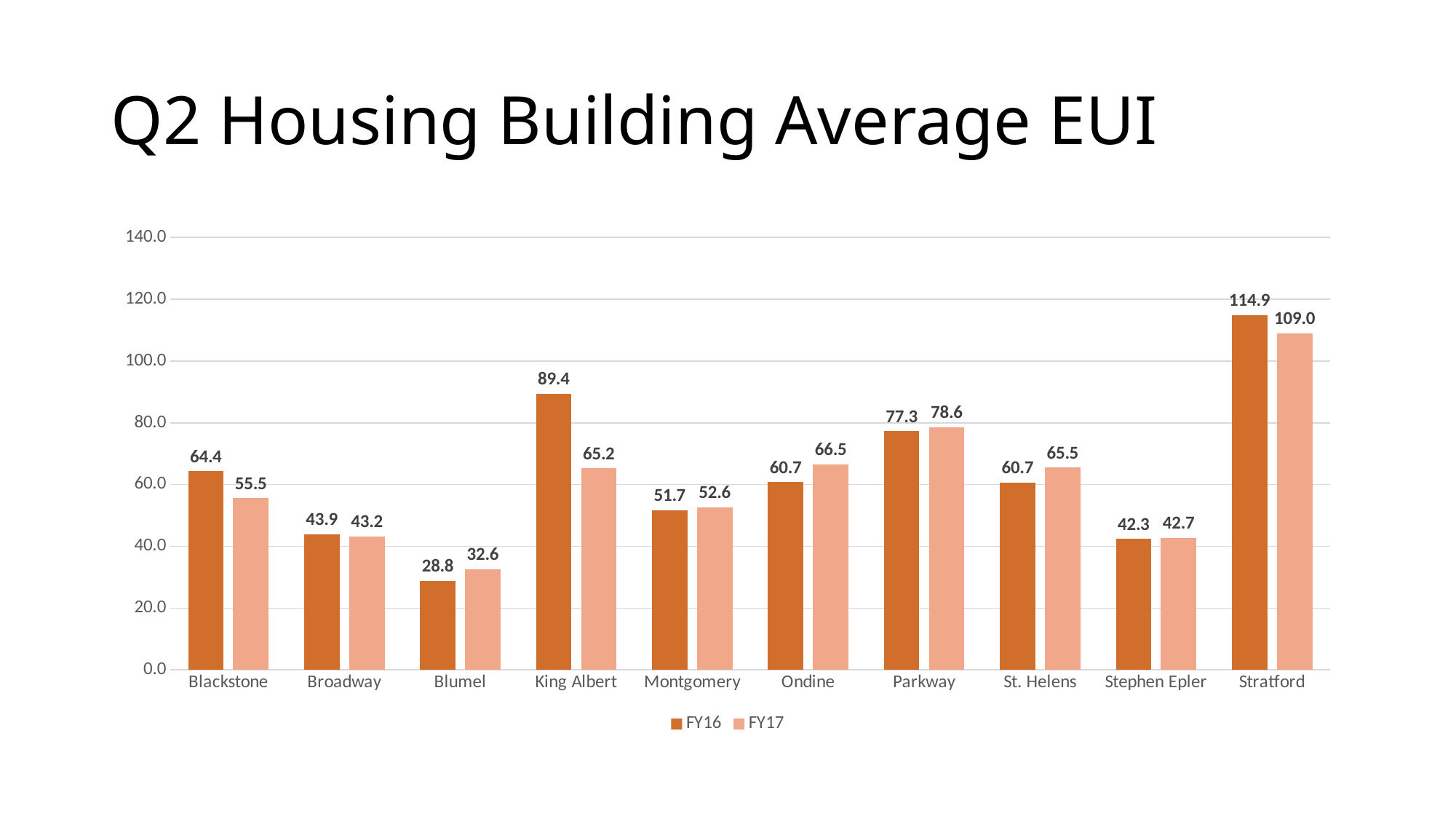
Is the FY16 value for Stratford greater or less than 100.0? greater How many buildings are shown on the x axis? 10 What is the FY16 value for King Albert? 89.4 What is the FY17 value for Blackstone? 55.5 What kind of chart is shown on the slide? Bar chart What is the FY17 value for Stratford? 109.0 Which building has the highest FY16 value? Stratford What is the difference between the FY16 and FY17 values for King Albert? 24.2 Which is larger for Ondine, the FY16 value or the FY17 value? FY17 How many series does the legend list? 2 What is the title of the slide? Q2 Housing Building Average EUI Which building has the lowest FY17 value? Blumel